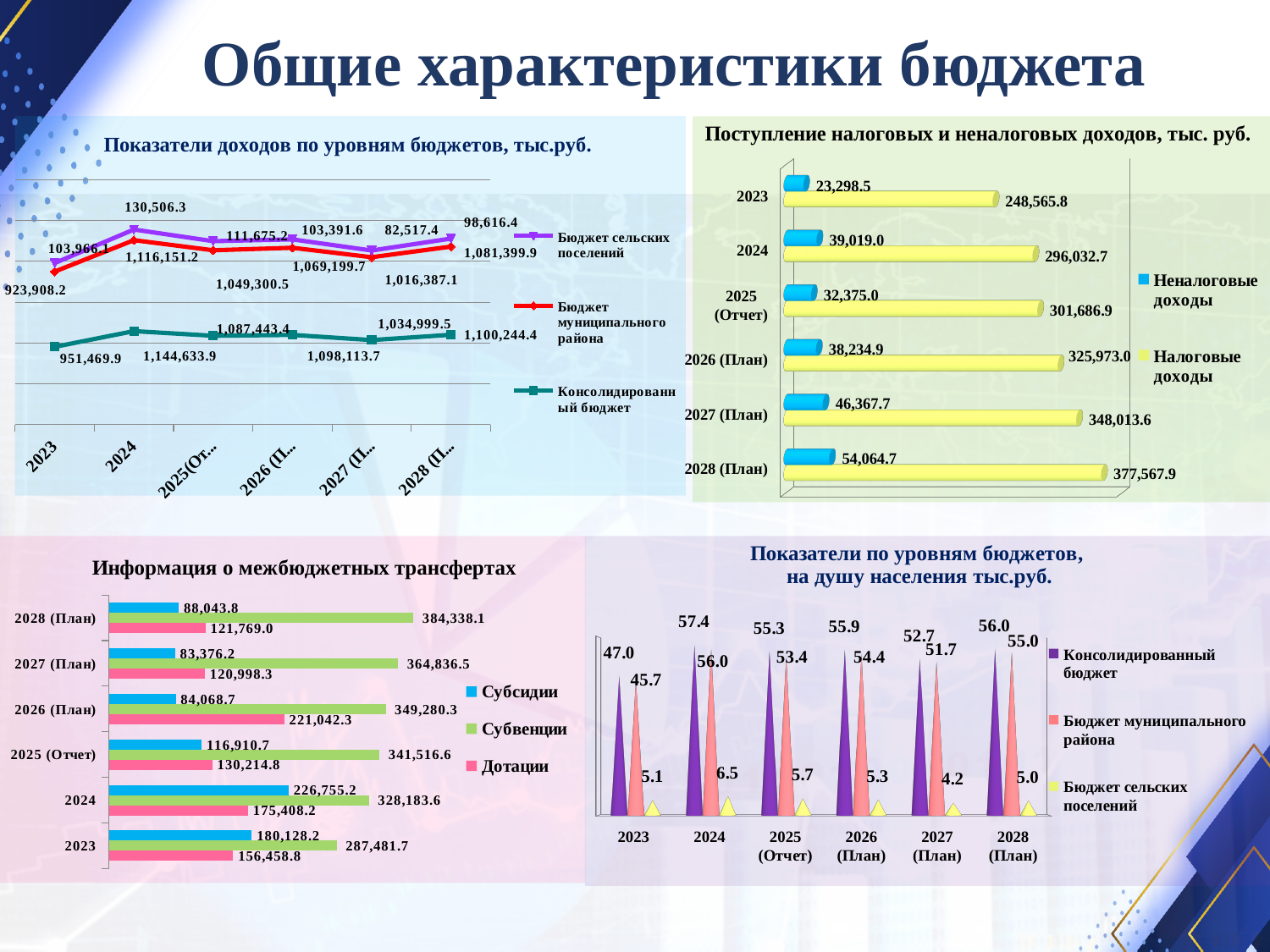
In the chart 'Поступление налоговых и неналоговых доходов, тыс. руб.', do the Налоговые доходы values rise or fall from 2023 to 2028 (План)? rise In the chart 'Информация о межбюджетных трансфертах', what is the value of Субвенции for 2026 (План)? 349,280.3 What type of chart is 'Показатели доходов по уровням бюджетов, тыс.руб.'? line chart In the chart 'Поступление налоговых и неналоговых доходов, тыс. руб.', what is the difference between Налоговые доходы in 2024 and in 2023? 47,466.9 In the chart 'Поступление налоговых и неналоговых доходов, тыс. руб.', which year has the lowest value of Неналоговые доходы? 2023 In the chart 'Показатели по уровням бюджетов, на душу населения тыс.руб.', which year has the lowest value of Бюджет сельских поселений? 2027 (План) In the chart 'Информация о межбюджетных трансфертах', which year has the highest value of Субсидии? 2024 How many series does the legend of the chart 'Информация о межбюджетных трансфертах' list? 3 In the chart 'Поступление налоговых и неналоговых доходов, тыс. руб.', what is the value of Налоговые доходы for 2028 (План)? 377,567.9 In the chart 'Показатели доходов по уровням бюджетов, тыс.руб.', what is the value of Бюджет сельских поселений for 2024? 130,506.3 In the chart 'Показатели по уровням бюджетов, на душу населения тыс.руб.', what is the value of Консолидированный бюджет for 2024? 57.4 In the chart 'Информация о межбюджетных трансфертах', which is larger for 2025 (Отчет): Субсидии or Дотации? Дотации